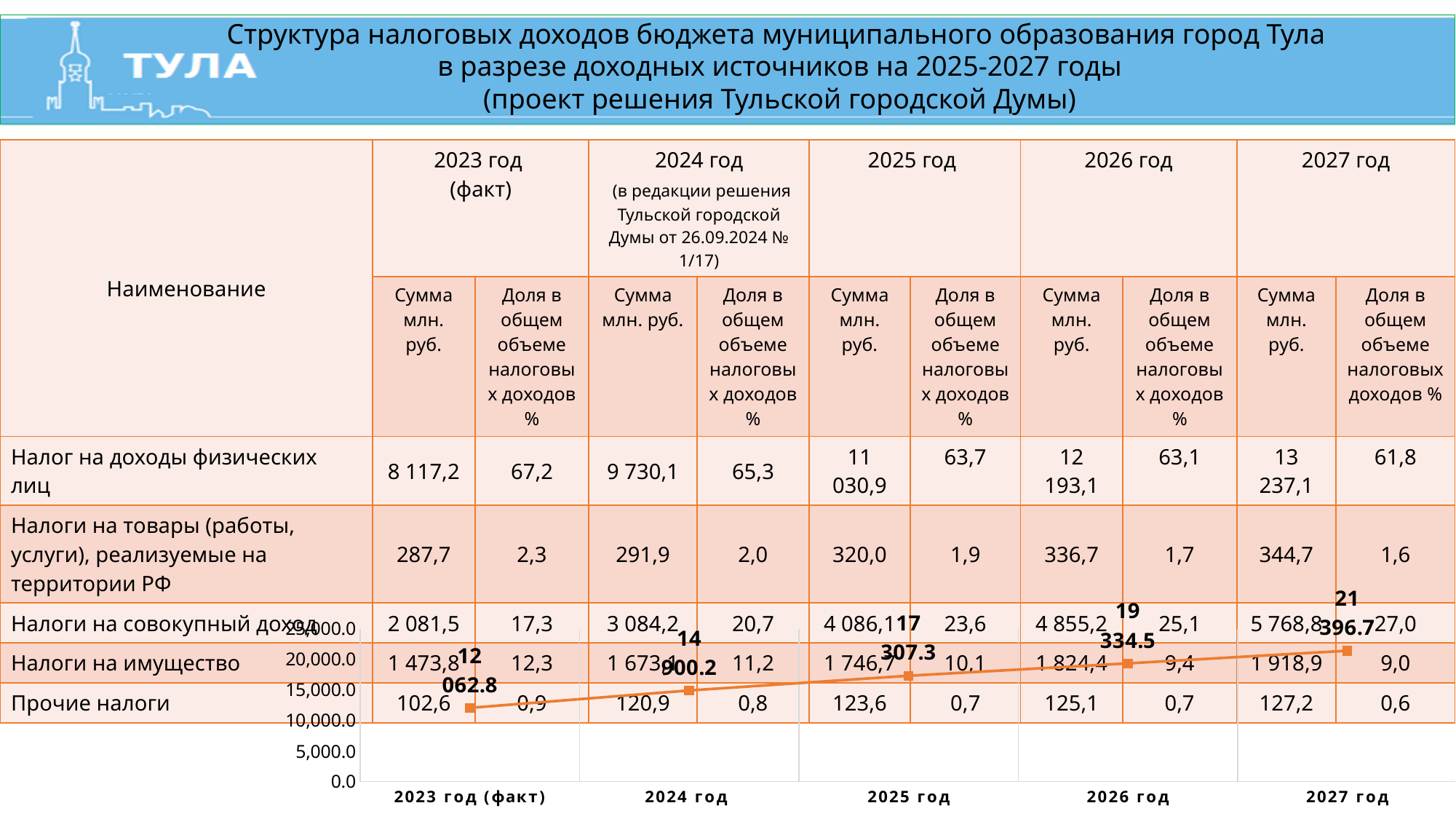
On the line chart, which is larger: the value for 2026 год or the value for 2024 год? 2026 год Do the values on the line chart rise or fall from 2023 год (факт) to 2027 год? rise Which year has the lowest value on the line chart? 2023 год (факт) Which year has the highest value on the line chart? 2027 год What is the difference between the 2024 год and 2023 год (факт) values on the line chart? 2 837.4 Is the value for 2025 год on the line chart greater or less than 15,000.0? greater How many data points are plotted on the line chart? 5 What is the value plotted for 2023 год (факт) on the line chart? 12 062.8 What is the value plotted for 2025 год on the line chart? 17 307.3 What is the difference between the 2027 год and 2026 год values on the line chart? 2 062.2 What kind of chart is shown at the bottom of the slide? line chart What is the value plotted for 2027 год on the line chart? 21 396.7